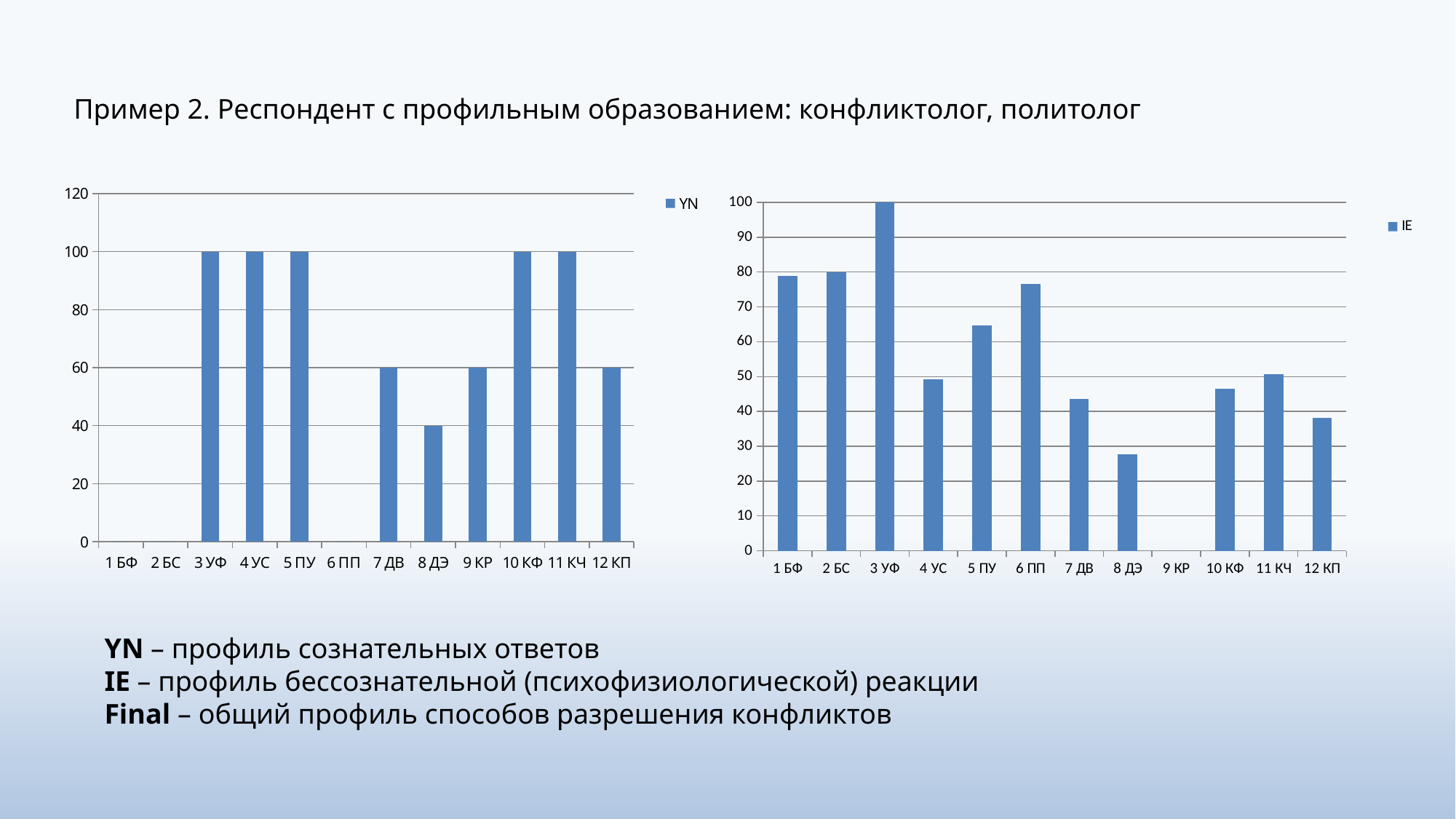
In the right chart (IE), which category has the lowest value? 9 КР In the right chart (IE), which category has the highest value? 3 УФ How many series does the legend of the left chart (YN) list? 1 In the right chart (IE), is the value for 8 ДЭ greater or less than 30? less In the right chart (IE), which is larger: the value for 5 ПУ or the value for 4 УС? 5 ПУ In the left chart (YN), what is the value for 3 УФ? 100 In the left chart (YN), what is the value for 8 ДЭ? 40 In the left chart (YN), what is the difference between the values for 3 УФ and 7 ДВ? 40 What kind of chart is the left chart (YN)? bar chart In the right chart (IE), is the value for 6 ПП greater or less than 70? greater How many categories are shown on the x axis of the right chart (IE)? 12 What series name is shown in the legend of the right chart? IE